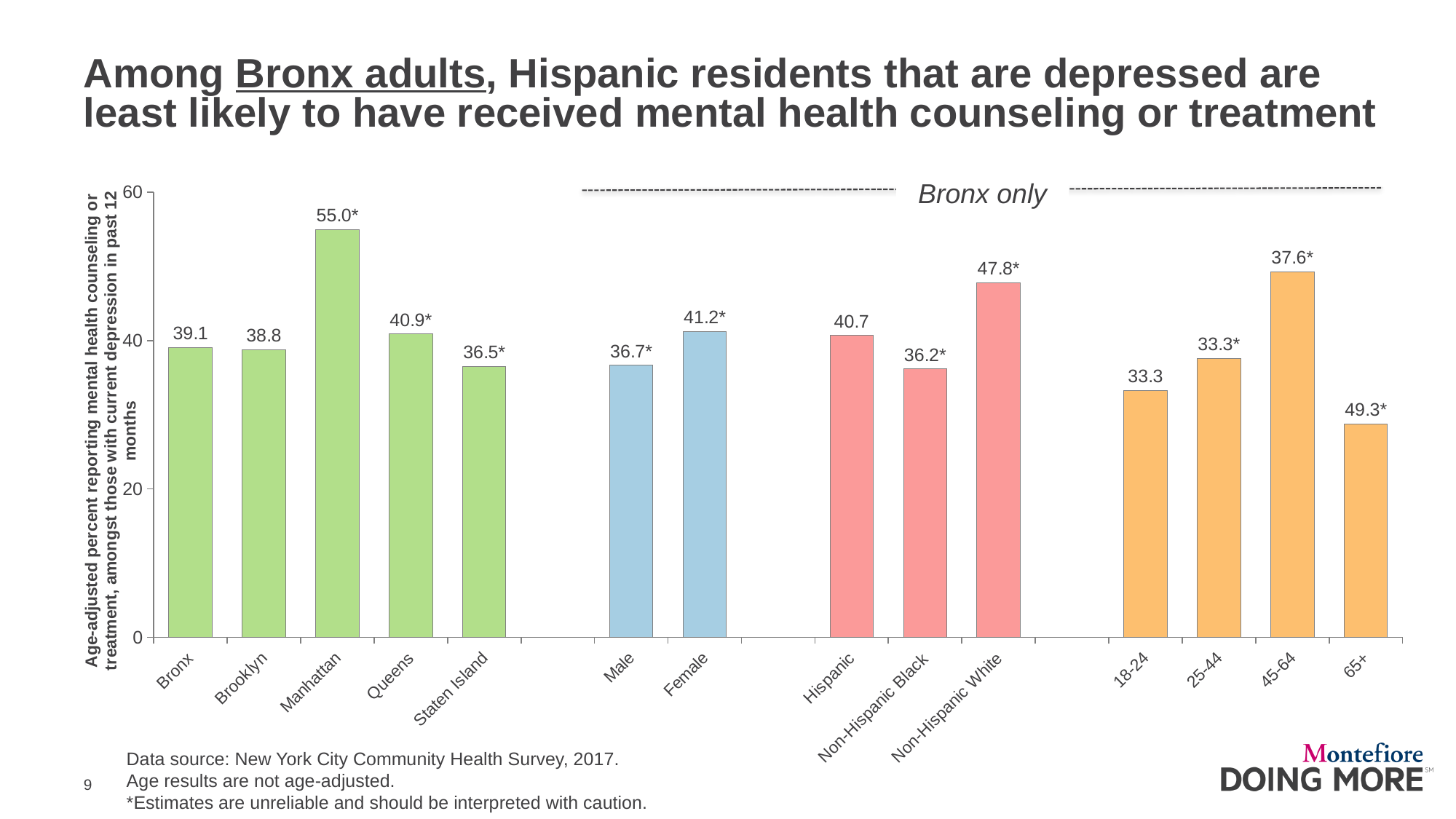
What is the value shown for Hispanic residents? 40.7 What is the difference between the Female and Male values? 4.5 What is the value shown for Non-Hispanic White? 47.8* What type of chart is shown on the slide? bar chart Which borough has the highest value? Manhattan What annotation appears above the right-hand groups of bars? Bronx only Which is larger, the value for Non-Hispanic White or the value for Hispanic? Non-Hispanic White What is the value shown for Female? 41.2* Is the value for Manhattan greater or less than 40? greater How many bars are plotted in the chart? 14 What is the value shown for Manhattan? 55.0* Which borough has the lowest value? Staten Island